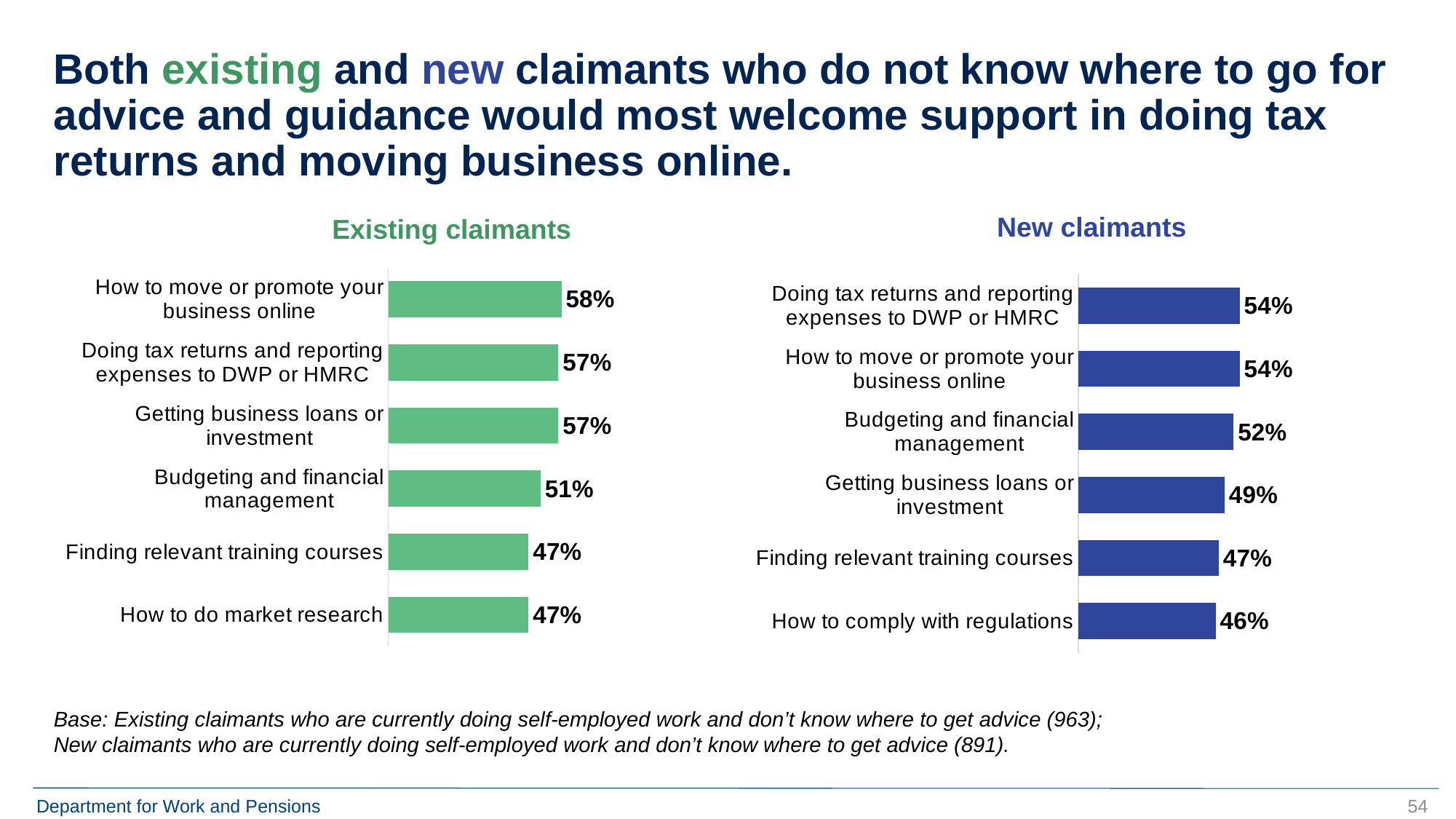
In the New claimants chart, what is the difference between 'Doing tax returns and reporting expenses to DWP or HMRC' and 'Finding relevant training courses'? 7% In the New claimants chart, which category has the lowest value? How to comply with regulations In the New claimants chart, which is larger: 'Budgeting and financial management' or 'Getting business loans or investment'? Budgeting and financial management In the New claimants chart, what is the value for 'Getting business loans or investment'? 49% In the Existing claimants chart, what is the difference between 'How to move or promote your business online' and 'How to do market research'? 11% What type of chart is the New claimants chart? Bar chart In the Existing claimants chart, which category has the highest value? How to move or promote your business online What colour are the bars in the Existing claimants chart? Green How many categories are shown in the Existing claimants chart? 6 How many categories are shown in the New claimants chart? 6 In the Existing claimants chart, which is larger: 'Budgeting and financial management' or 'Finding relevant training courses'? Budgeting and financial management In the Existing claimants chart, what is the value for 'Budgeting and financial management'? 51%